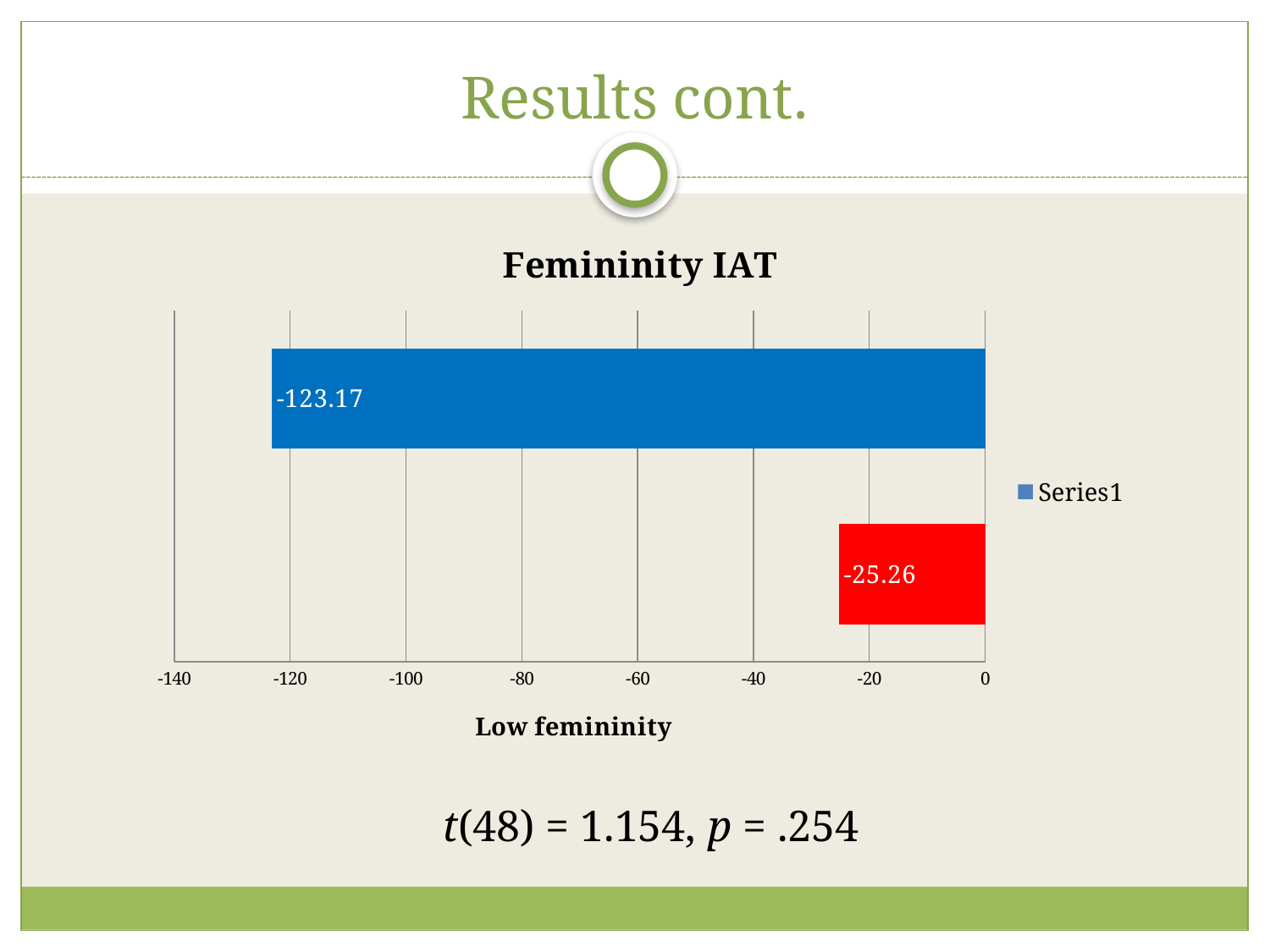
What label appears below the horizontal axis of the Femininity IAT chart? Low femininity What is the title of the chart on the slide? Femininity IAT Which bar in the Femininity IAT chart has the lower value, the blue bar or the red bar? the blue bar How many bars are plotted in the Femininity IAT chart? 2 Is the value of the blue bar in the Femininity IAT chart greater or less than -100? less Which bar in the Femininity IAT chart extends furthest from zero? the blue bar How many series does the legend of the Femininity IAT chart list? 1 What kind of chart is shown on the slide? bar chart What is the value shown on the red bar in the Femininity IAT chart? -25.26 What is the value shown on the blue bar in the Femininity IAT chart? -123.17 Is the value of the red bar in the Femininity IAT chart greater or less than -40? greater What is the difference between the values of the blue bar and the red bar in the Femininity IAT chart? 97.91